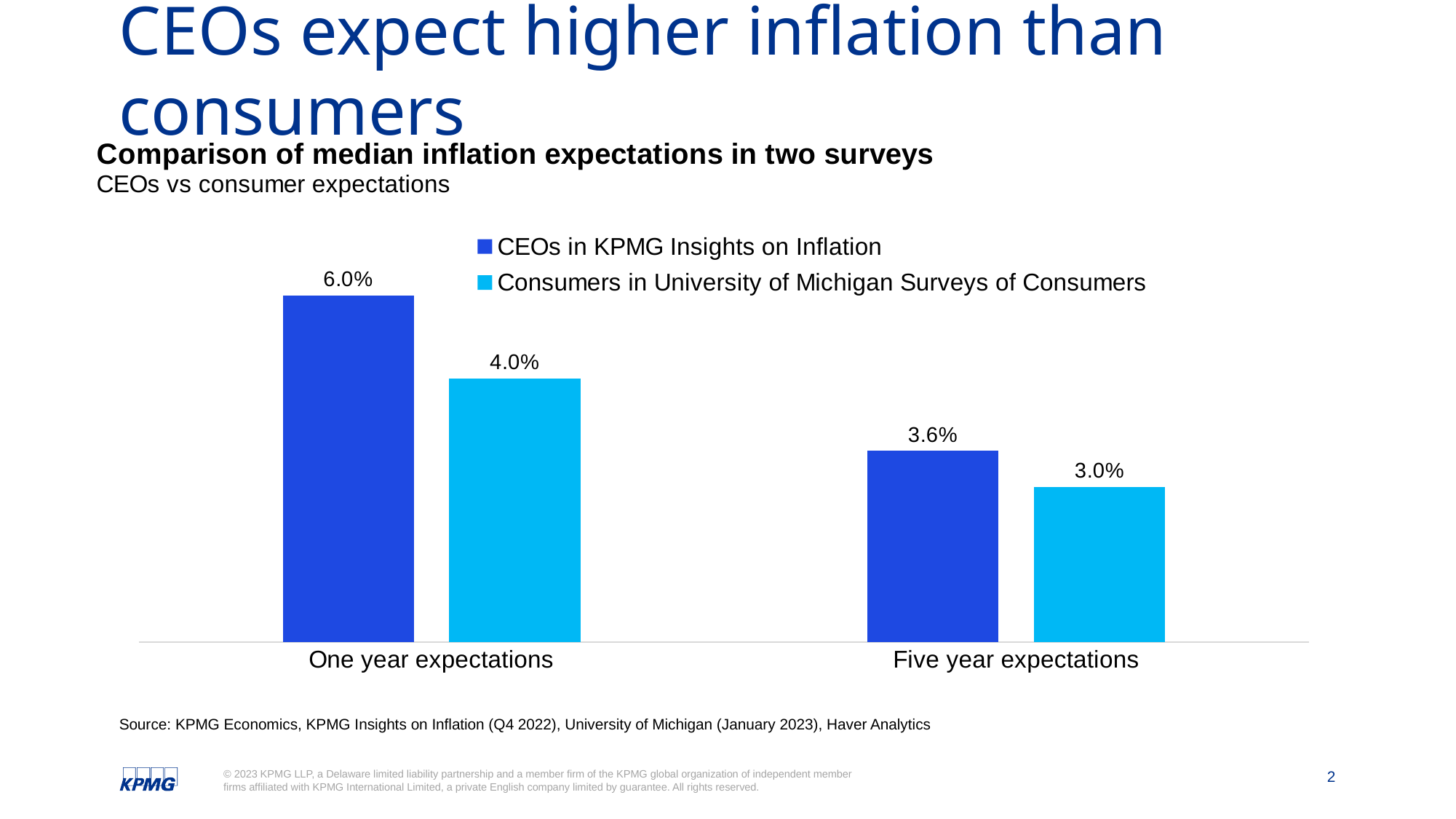
What is the difference between CEO and consumer five year expectations? 0.6% How many series does the legend list? 2 What is the median five year inflation expectation for CEOs in KPMG Insights on Inflation? 3.6% Which bar shows the highest value on the chart? CEOs, One year expectations What is the difference between CEO and consumer one year expectations? 2.0% What is the median five year inflation expectation for Consumers in University of Michigan Surveys of Consumers? 3.0% For five year expectations, which group expects higher inflation, CEOs or consumers? CEOs Which bar shows the lowest value on the chart? Consumers, Five year expectations How many categories are shown on the x axis? 2 What is the median one year inflation expectation for Consumers in University of Michigan Surveys of Consumers? 4.0% What kind of chart is shown on the slide? Bar chart What is the median one year inflation expectation for CEOs in KPMG Insights on Inflation? 6.0%